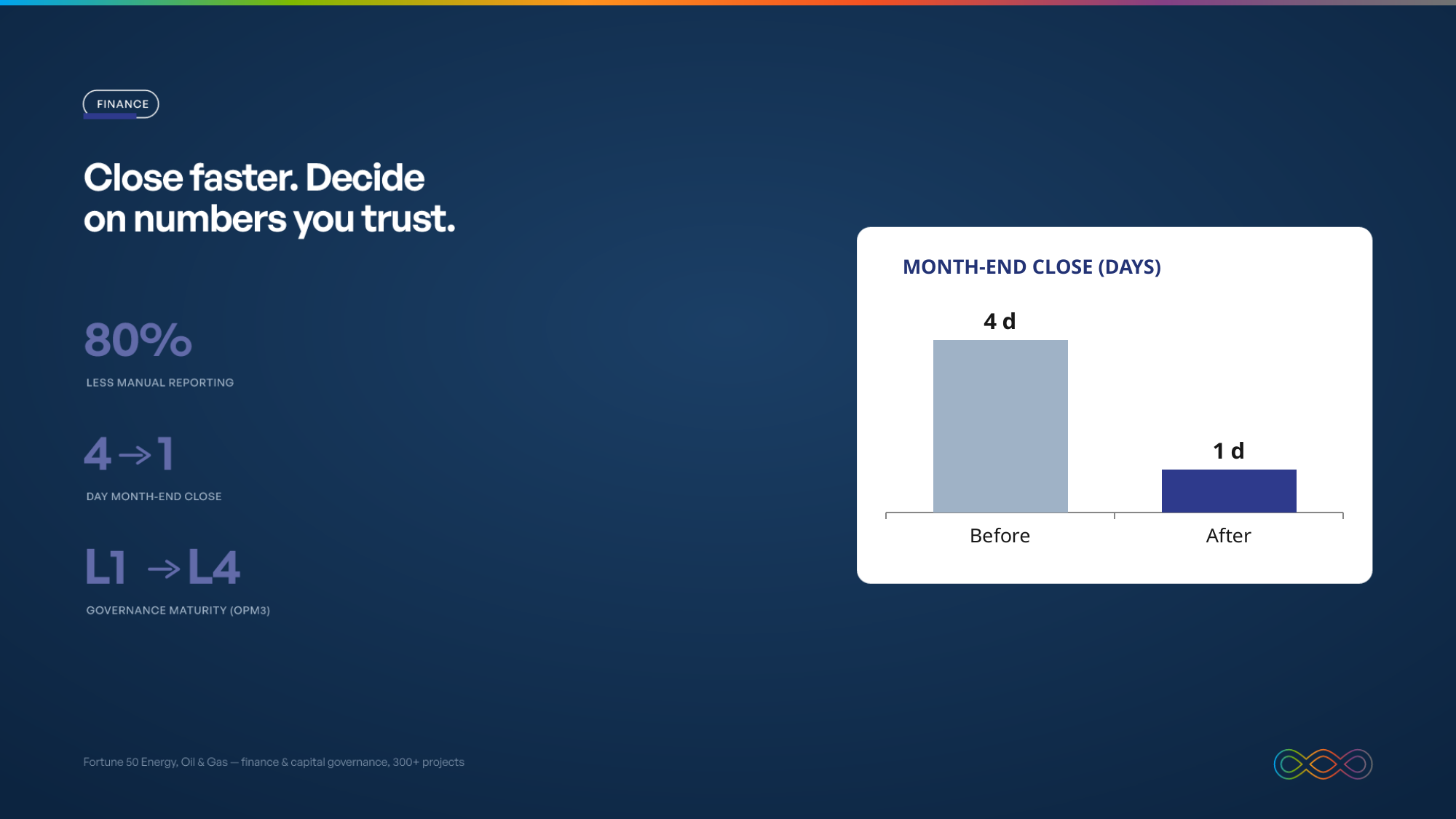
Which is larger in the Month-End Close chart, Before or After? Before What colour is the After bar in the Month-End Close chart? Dark blue How many categories are shown in the Month-End Close chart? 2 What is the title of the chart on the slide? MONTH-END CLOSE (DAYS) What is the value for After in the Month-End Close chart? 1 d What kind of chart is the Month-End Close chart? Bar chart What is the value for Before in the Month-End Close chart? 4 d Which category has the highest value in the Month-End Close chart? Before Which category has the lowest value in the Month-End Close chart? After What is the difference between the Before and After values in the Month-End Close chart? 3 d Do the values rise or fall from Before to After in the Month-End Close chart? Fall